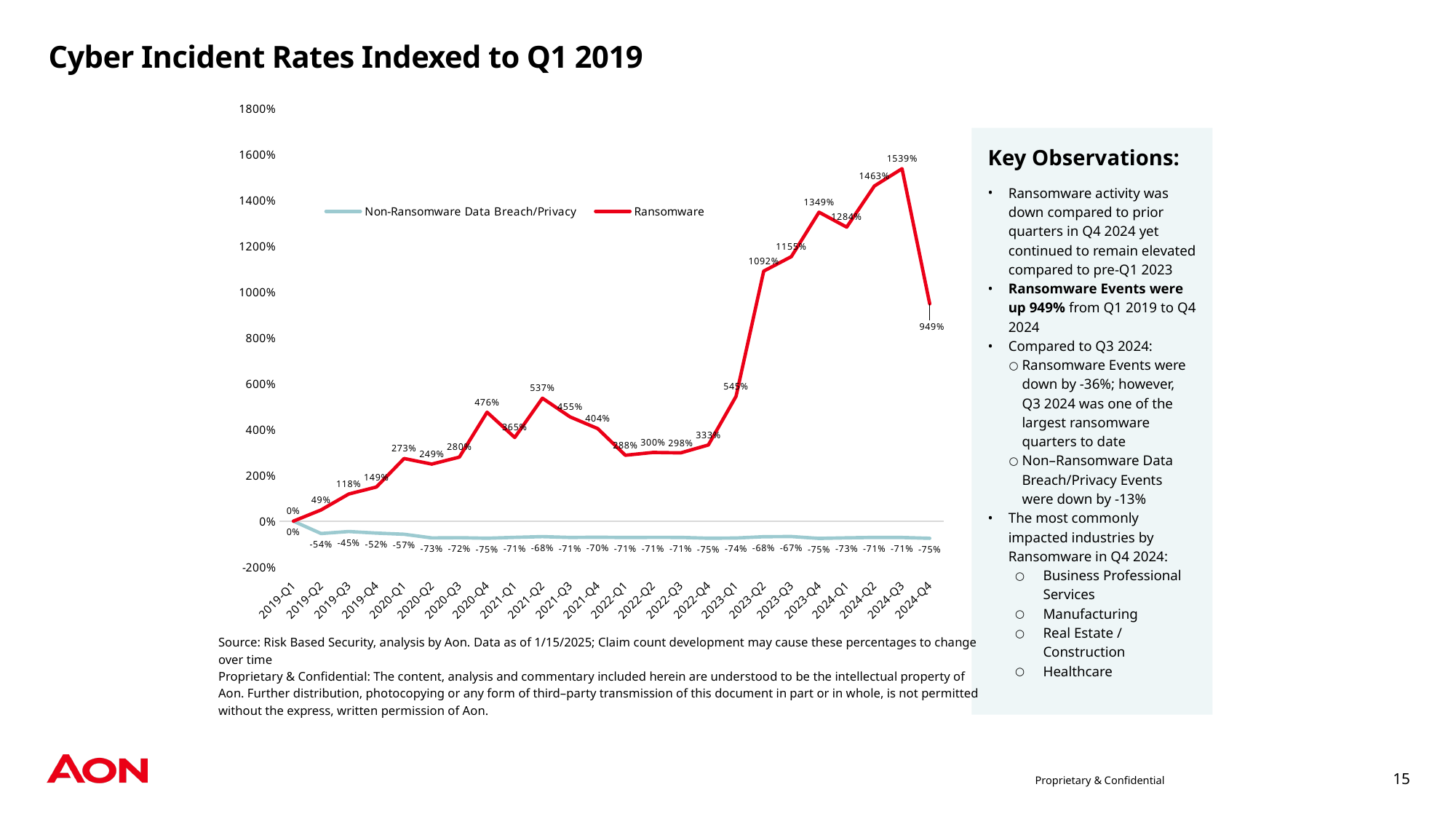
What is the Non-Ransomware Data Breach/Privacy value for 2024-Q4? -75% What is the Ransomware value for 2024-Q3? 1539% Which quarter has the higher Ransomware value, 2020-Q4 or 2021-Q2? 2021-Q2 By how many percentage points did the Ransomware value fall from 2024-Q3 to 2024-Q4? 590 percentage points How many series does the legend list? 2 What is the Ransomware value for 2024-Q4? 949% What kind of chart is shown on the slide? Line chart What is the Non-Ransomware Data Breach/Privacy value for 2019-Q2? -54% What is the Ransomware value for 2023-Q2? 1092% Does the Ransomware series rise or fall from 2022-Q4 to 2024-Q3? Rise In which quarter does the Ransomware series reach its highest value? 2024-Q3 How many quarters are plotted along the x axis? 24